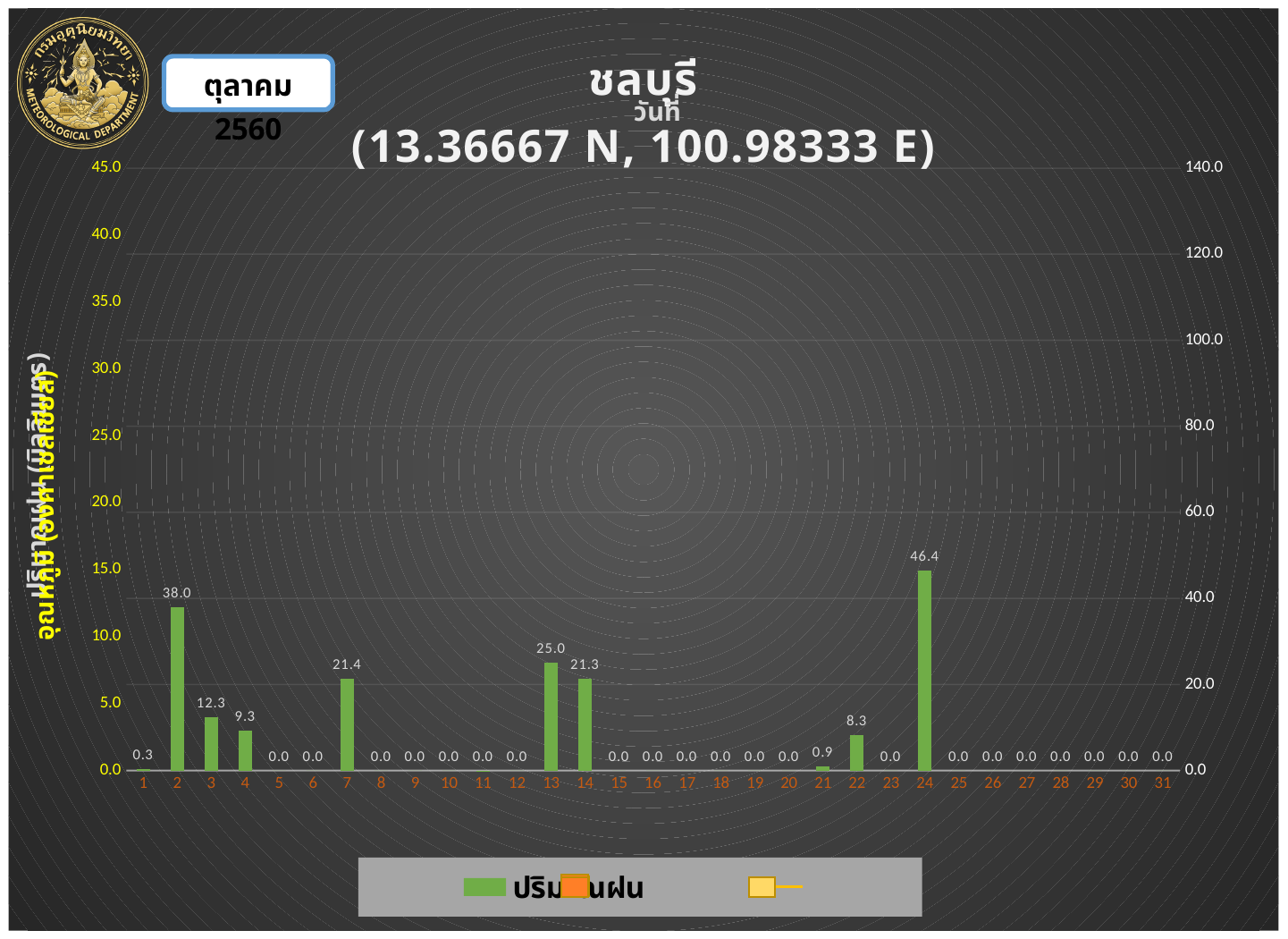
What is the rainfall value shown for day 22? 8.3 Which day has the highest rainfall value? 24 Which is larger, the rainfall value for day 13 or for day 22? day 13 What is the difference between the rainfall values for day 7 and day 14? 0.1 What is the difference between the rainfall values for day 24 and day 2? 8.4 What kind of chart is shown on the slide? bar chart What is the rainfall value shown for day 13? 25.0 How many days are shown on the x axis? 31 What is the name of the province shown in the chart title? ชลบุรี What is the rainfall value shown for day 24? 46.4 Which is larger, the rainfall value for day 3 or for day 4? day 3 What is the rainfall value shown for day 2? 38.0